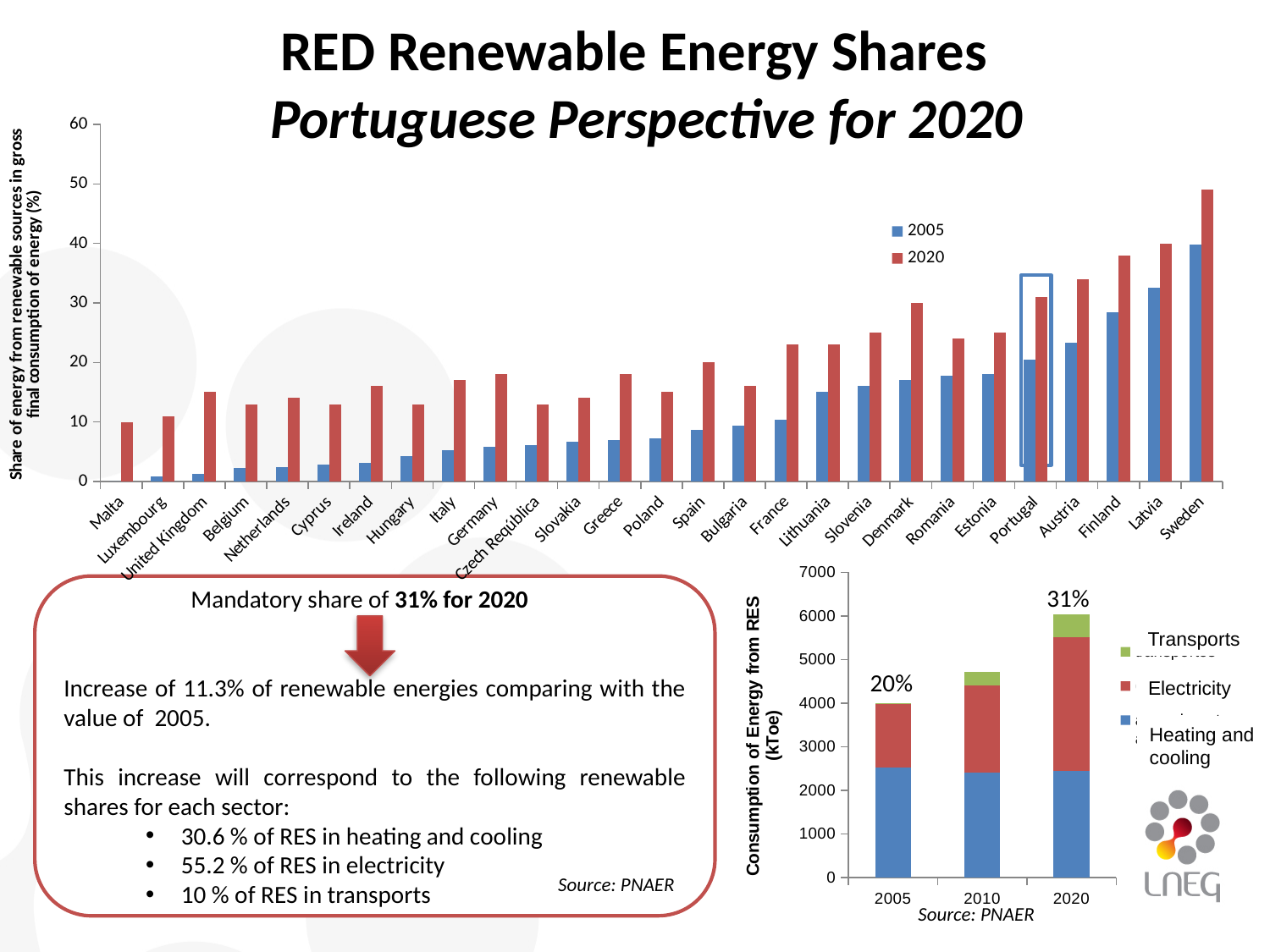
In the top chart of renewable energy shares by country, which is larger: the 2020 value for Denmark or the 2020 value for Romania? Denmark In the bottom-right chart of consumption of energy from RES, how many series does the legend list? 3 In the bottom-right chart of consumption of energy from RES, what percentage label is shown above the 2020 bar? 31% In the bottom-right chart of consumption of energy from RES, what percentage label is shown above the 2005 bar? 20% In the top chart of renewable energy shares by country, which country has the highest 2020 value? Sweden In the top chart of renewable energy shares by country, how many series does the legend list? 2 In the top chart of renewable energy shares by country, how many countries are shown on the x axis? 27 In the top chart of renewable energy shares by country, is the 2020 value for Sweden greater or less than 40? greater In the top chart of renewable energy shares by country, which country has the lowest 2020 value? Malta In the top chart of renewable energy shares by country, is the 2005 value for Finland greater or less than 30? less In the top chart of renewable energy shares by country, what kind of chart is it? bar chart In the top chart of renewable energy shares by country, is the 2020 value for Germany greater or less than 20? less